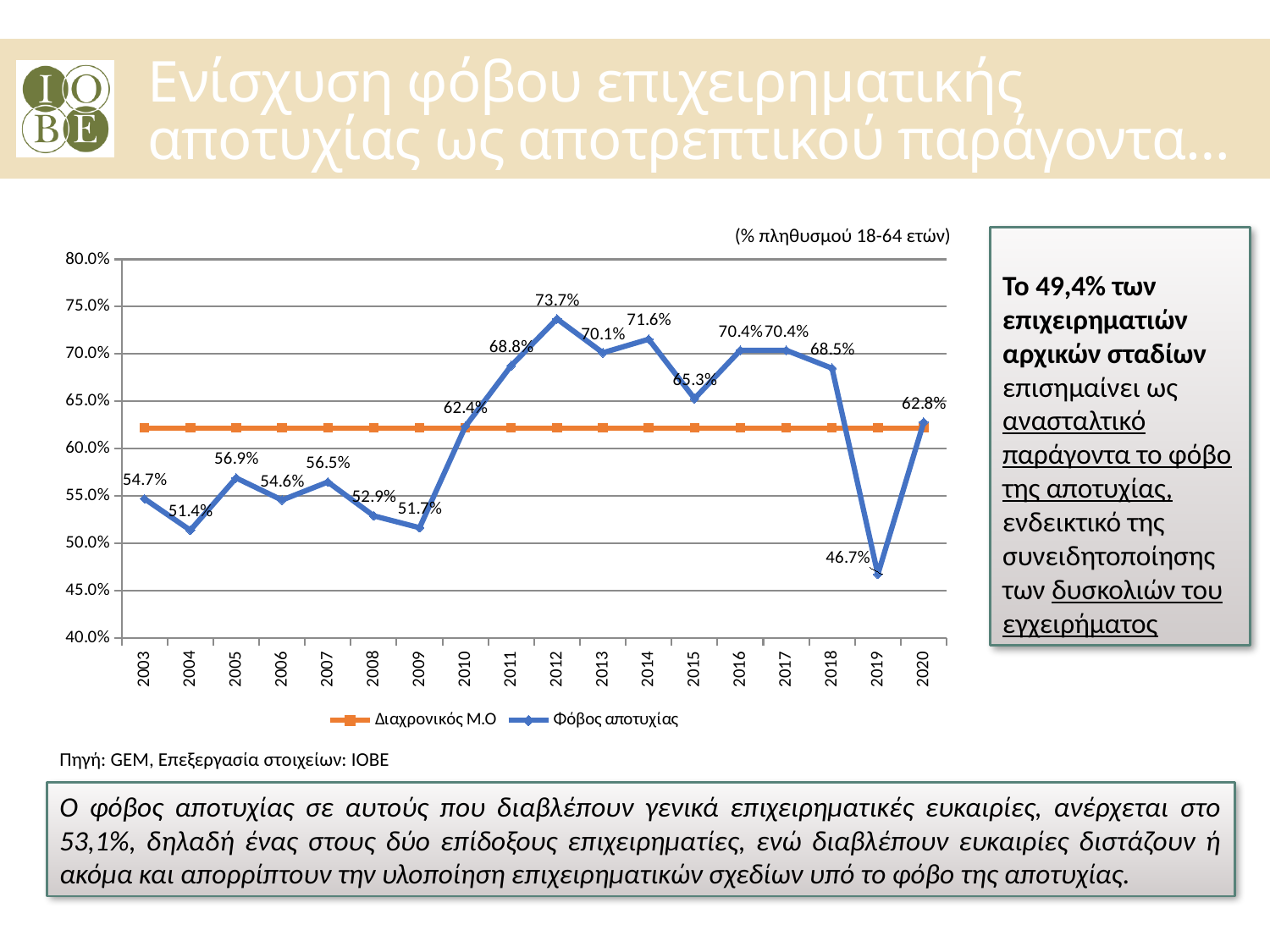
In which year is Φόβος αποτυχίας lowest? 2019 Does Φόβος αποτυχίας rise or fall from 2009 to 2012? rise What is the difference between the Φόβος αποτυχίας values for 2012 and 2019? 27.0% How many years are shown on the x axis of the chart? 18 Is the value of the Διαχρονικός Μ.Ο line greater or less than 60.0%? greater In which year is Φόβος αποτυχίας highest? 2012 What is the value of Φόβος αποτυχίας for 2012? 73.7% What is the value of Φόβος αποτυχίας for 2019? 46.7% How many series does the chart legend list? 2 What is the value of Φόβος αποτυχίας for 2020? 62.8% Which year has a higher Φόβος αποτυχίας value, 2011 or 2015? 2011 What kind of chart is shown on the slide? line chart